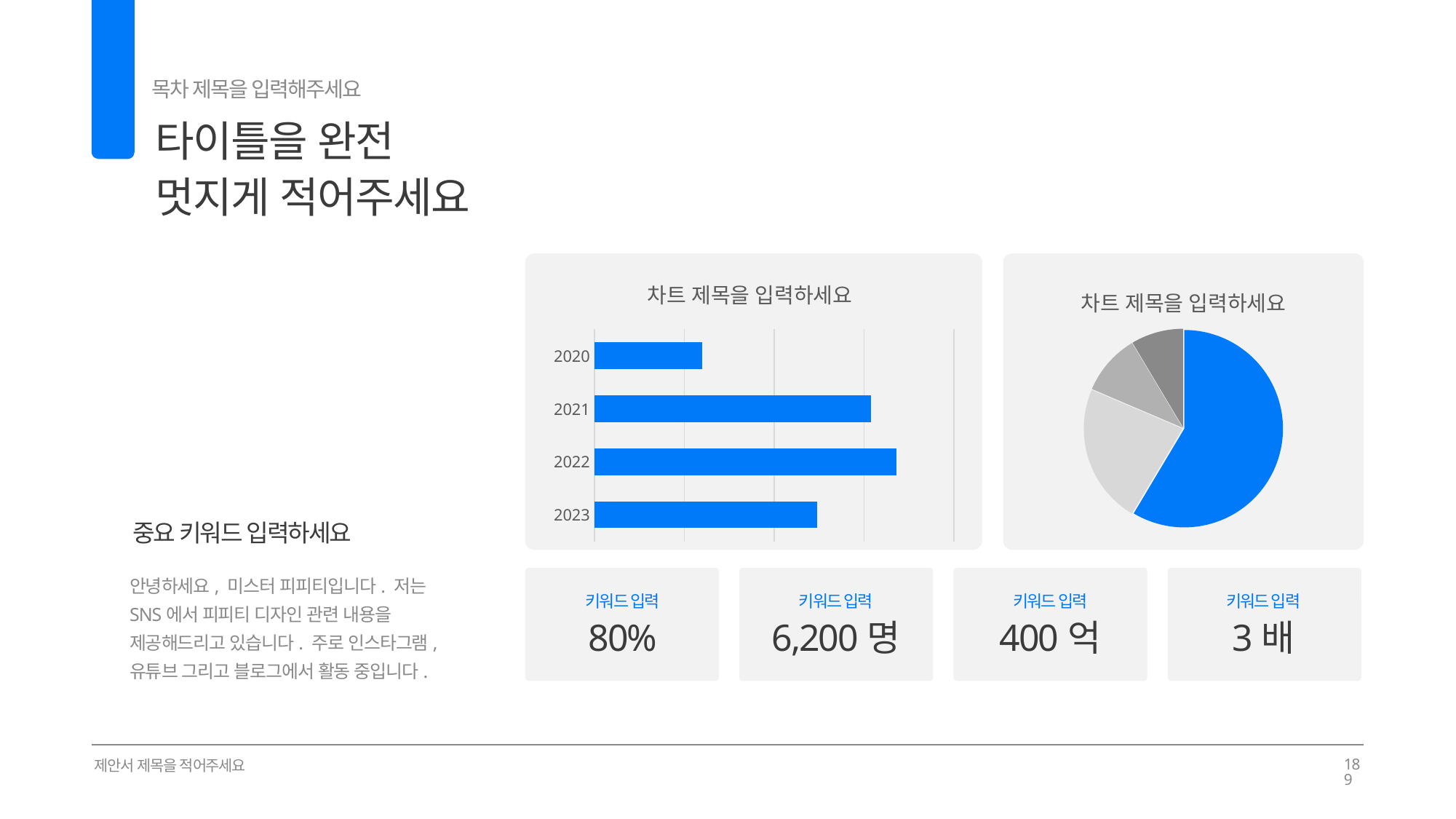
In the pie chart on the right, how many slices are there? 4 In the bar chart on the left, do the values rise or fall from 2020 to 2022? rise What is the title shown above the bar chart on the left? 차트 제목을 입력하세요 In the bar chart on the left, how many categories are plotted? 4 In the bar chart on the left, which has the larger value, 2021 or 2023? 2021 In the bar chart on the left, which year has the lowest value? 2020 In the bar chart on the left, which year has the highest value? 2022 What kind of chart is the chart on the right of the slide? pie chart In the pie chart on the right, what colour is the largest slice? blue What kind of chart is the chart on the left of the slide? bar chart In the bar chart on the left, which has the larger value, 2020 or 2023? 2023